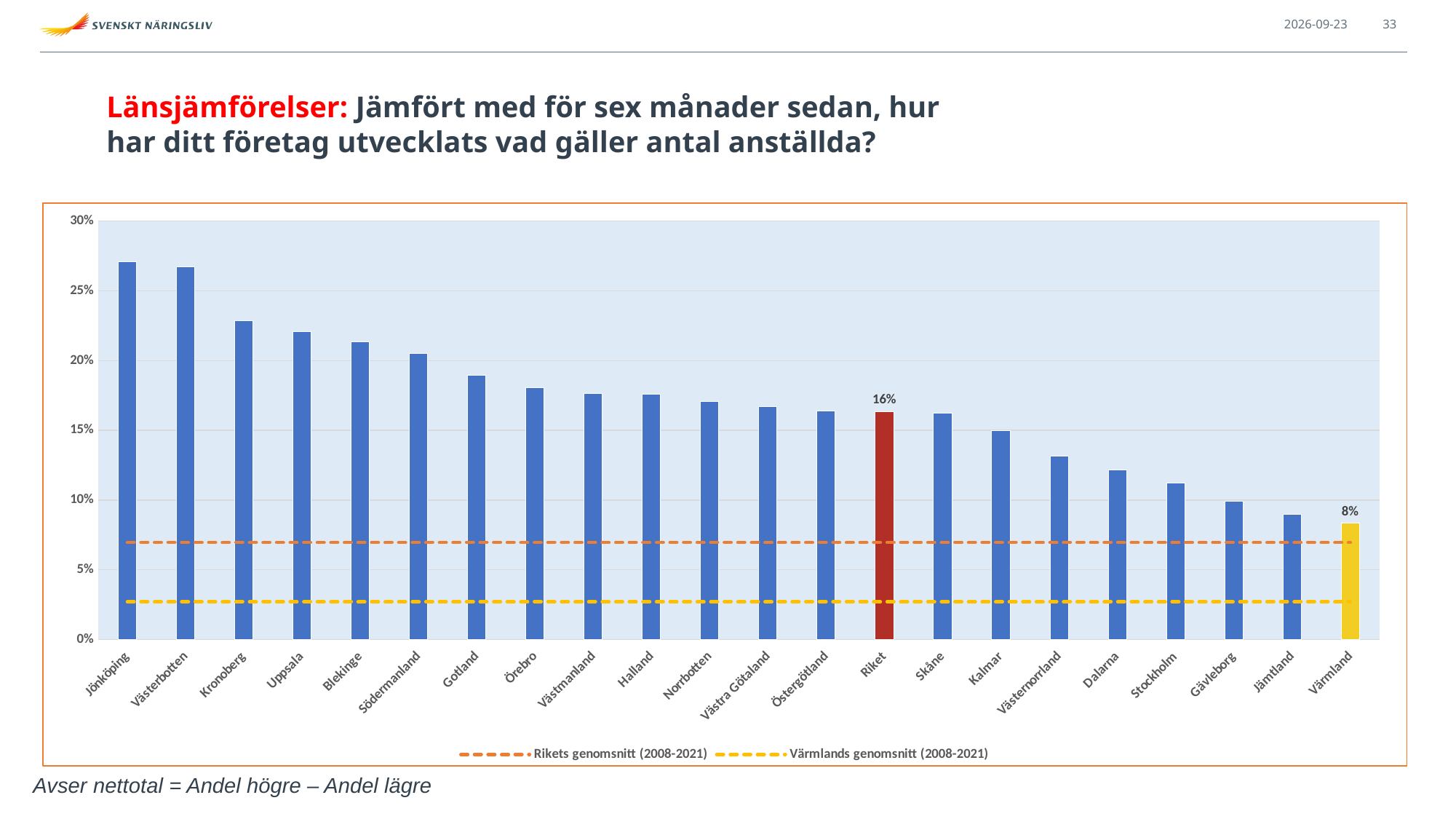
What is the difference between the values for Riket and Värmland? 8 percentage points How many entries does the legend list? 2 Do the bar values rise or fall from left to right along the x axis? fall Is the value for Jönköping greater or less than 25%? greater What is the value for Riket? 16% How many categories are shown on the x axis? 22 Is the value for Dalarna greater or less than 15%? less Which is larger, the value for Riket or the value for Värmland? Riket What is the value for Värmland? 8% Which category has the lowest value? Värmland What kind of chart is shown on the slide? bar chart Is the value for Kronoberg greater or less than 20%? greater